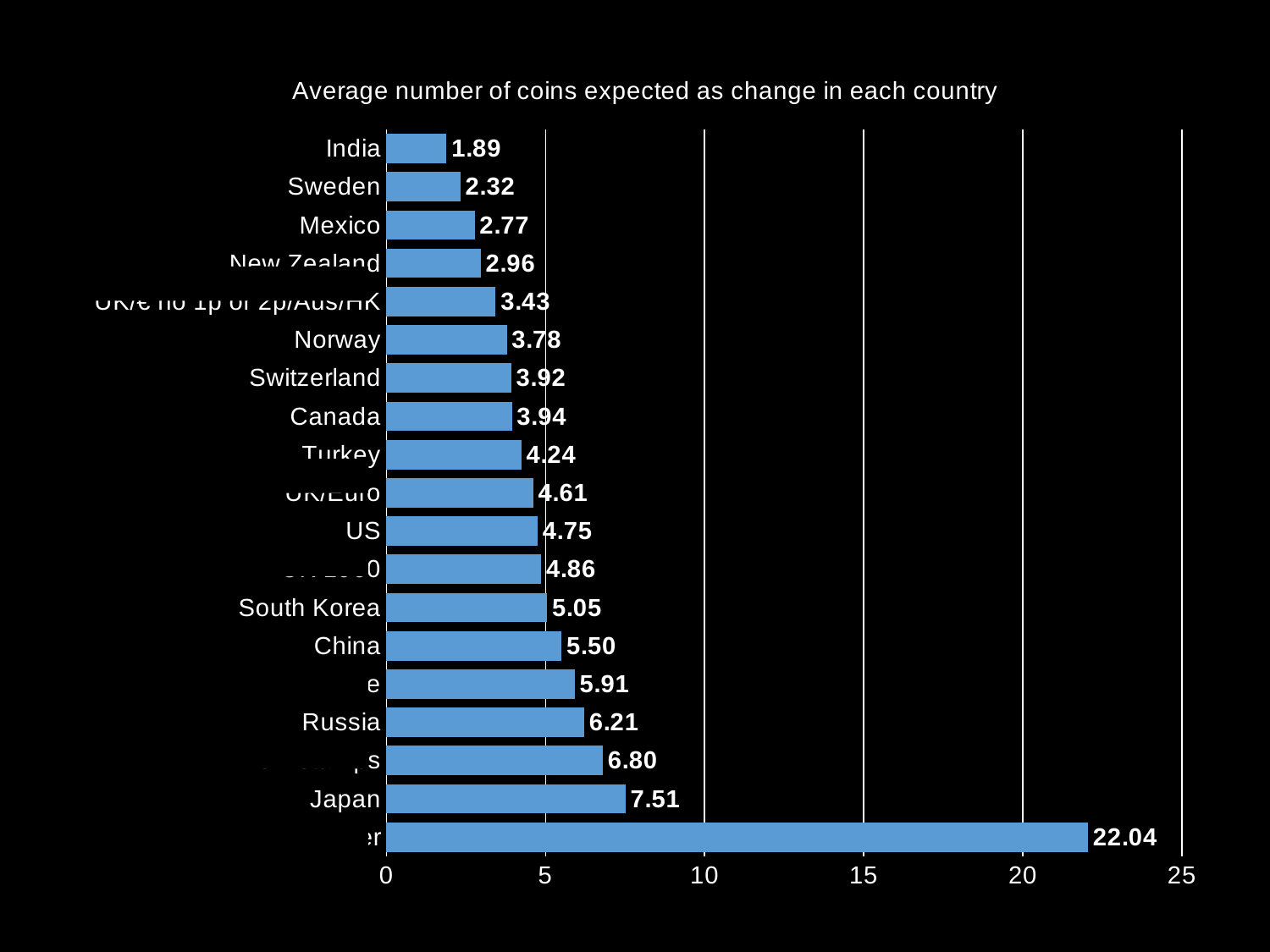
Is the value for Japan greater or less than 5? greater What is the difference between the values for Norway and Mexico? 1.01 What is the average number of coins expected as change in India? 1.89 What is the value shown for Japan? 7.51 What kind of chart is shown on the slide? Bar chart What is the title of the chart? Average number of coins expected as change in each country What is the difference between the values for Japan and Russia? 1.30 How many bars are plotted in the chart? 19 Which country has the lowest average number of coins expected as change? India What is the value shown for Sweden? 2.32 Which has a higher value, China or South Korea? China What is the value shown for Canada? 3.94